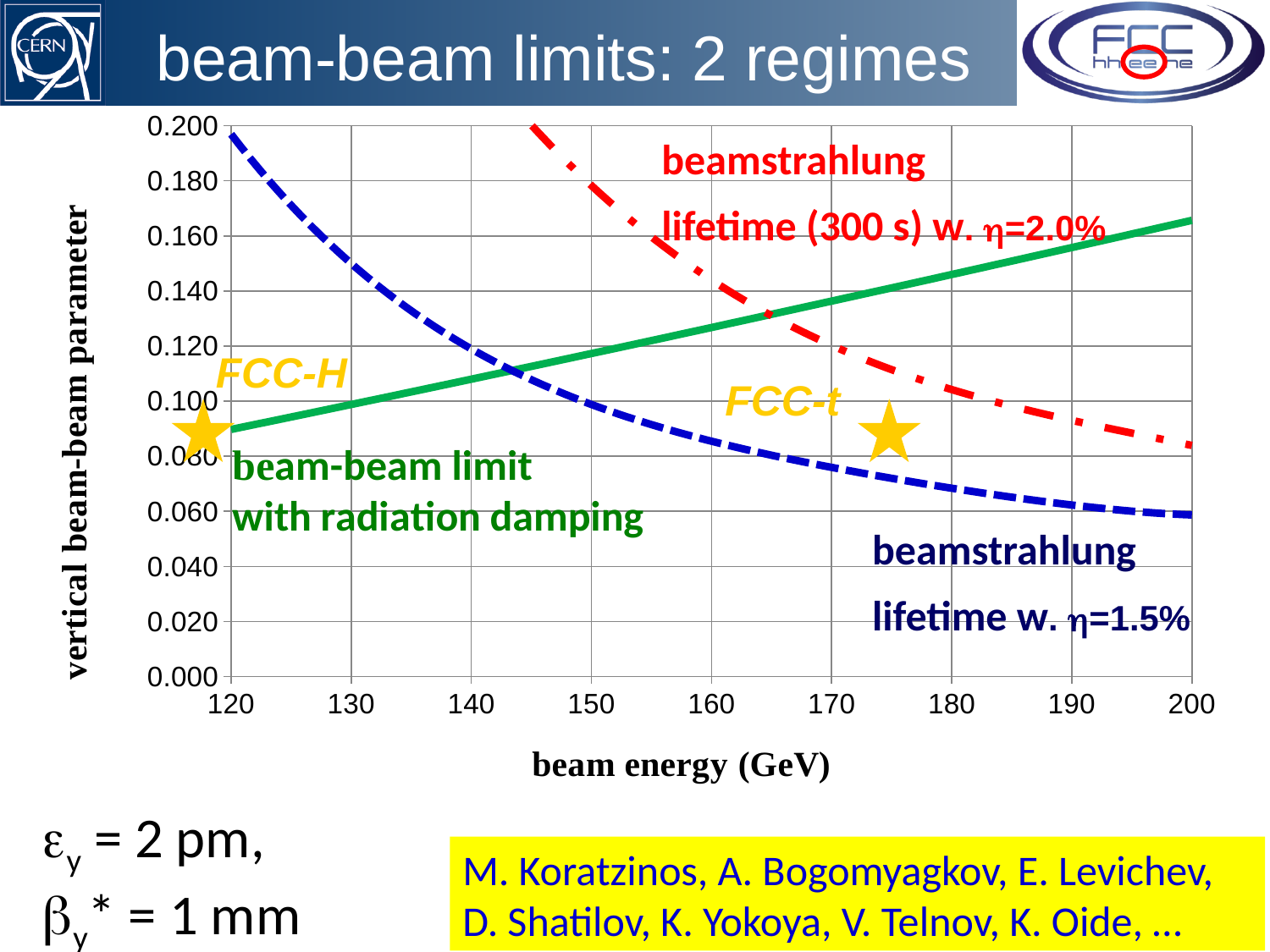
What is the label of the x axis of the chart? beam energy (GeV) Is the value of the blue dashed 'beamstrahlung lifetime w. η=1.5%' curve at 200 GeV greater or less than 0.080? less Is the value of the green 'beam-beam limit with radiation damping' curve at 200 GeV greater or less than 0.140? greater Does the blue dashed 'beamstrahlung lifetime w. η=1.5%' curve rise or fall as beam energy increases? fall What kind of chart is shown on the slide? line chart Does the red dash-dot 'beamstrahlung lifetime (300 s) w. η=2.0%' curve rise or fall as beam energy increases? fall Is the value of the red dash-dot 'beamstrahlung lifetime (300 s) w. η=2.0%' curve at 200 GeV greater or less than 0.100? less Does the green solid 'beam-beam limit with radiation damping' curve rise or fall as beam energy increases? rise How many curves are plotted on the chart? 3 At 130 GeV, which curve is higher: the blue dashed 'beamstrahlung lifetime w. η=1.5%' curve or the green 'beam-beam limit with radiation damping' curve? blue dashed beamstrahlung lifetime w. η=1.5% At 200 GeV, which curve is higher: the green 'beam-beam limit with radiation damping' curve or the blue dashed 'beamstrahlung lifetime w. η=1.5%' curve? green beam-beam limit with radiation damping